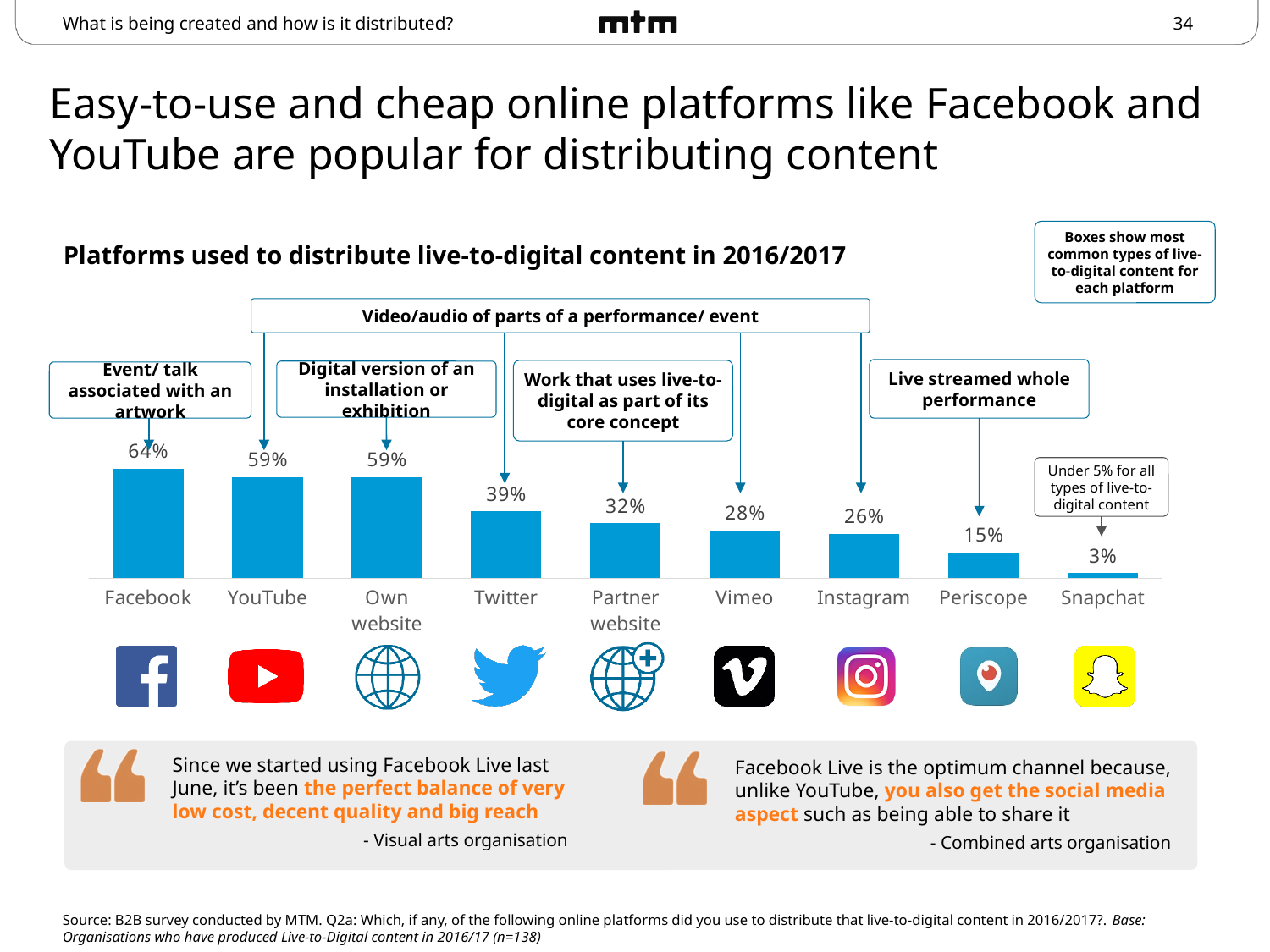
What is the difference between the values for Facebook and Instagram? 38 percentage points What percentage of organisations used Facebook to distribute live-to-digital content in 2016/2017? 64% Which has a higher value, Vimeo or Periscope? Vimeo What is the value shown for Twitter? 39% Do the values rise or fall moving from left to right across the platforms? Fall What type of chart is used to show the platforms? Bar chart What is the difference between the values for Twitter and Partner website? 7 percentage points Which platform has the lowest value in the chart? Snapchat Which platform has the highest value in the chart? Facebook What is the value shown for Periscope? 15% What is the title of the chart? Platforms used to distribute live-to-digital content in 2016/2017 How many platforms are shown in the chart? 9